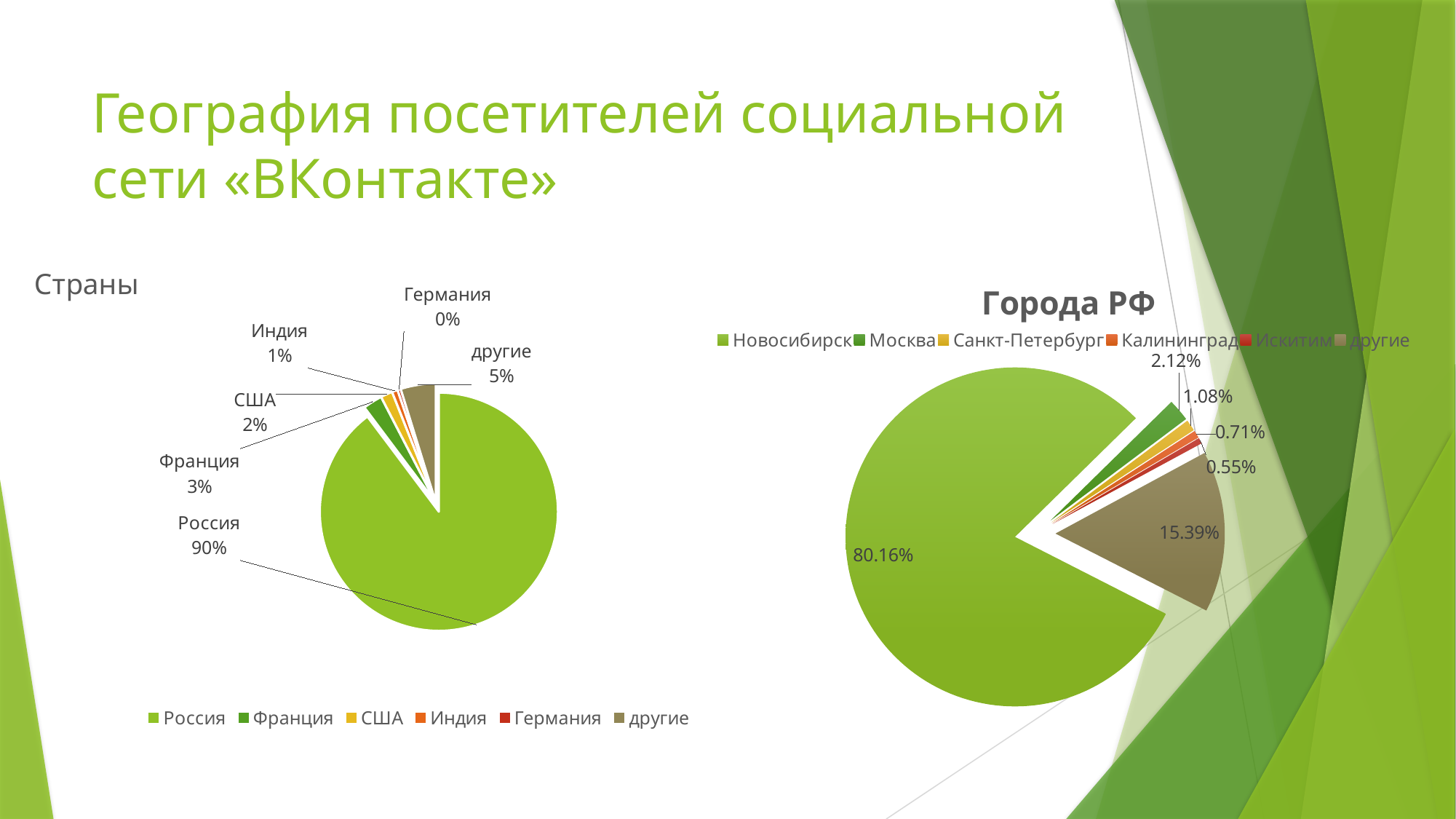
In the "Города РФ" chart, what share is labelled for другие? 15.39% In the "Страны" chart, what share is labelled for Германия? 0% What kind of chart is the "Города РФ" chart? Pie chart In the "Страны" chart, what share is labelled for Франция? 3% In the "Страны" chart, what is the difference between the shares for другие and США? 3% In the "Города РФ" chart, what share is labelled for Москва? 2.12% In the "Страны" chart, how many categories does the legend list? 6 In the "Страны" chart, which category has the largest slice? Россия In the "Города РФ" chart, what share is labelled for Новосибирск? 80.16% In the "Страны" chart, what share of visitors is from Россия? 90% In the "Города РФ" chart, which is larger: the share for Санкт-Петербург or the share for Калининград? Санкт-Петербург In the "Города РФ" chart, what is the difference between the shares for Новосибирск and другие? 64.77%